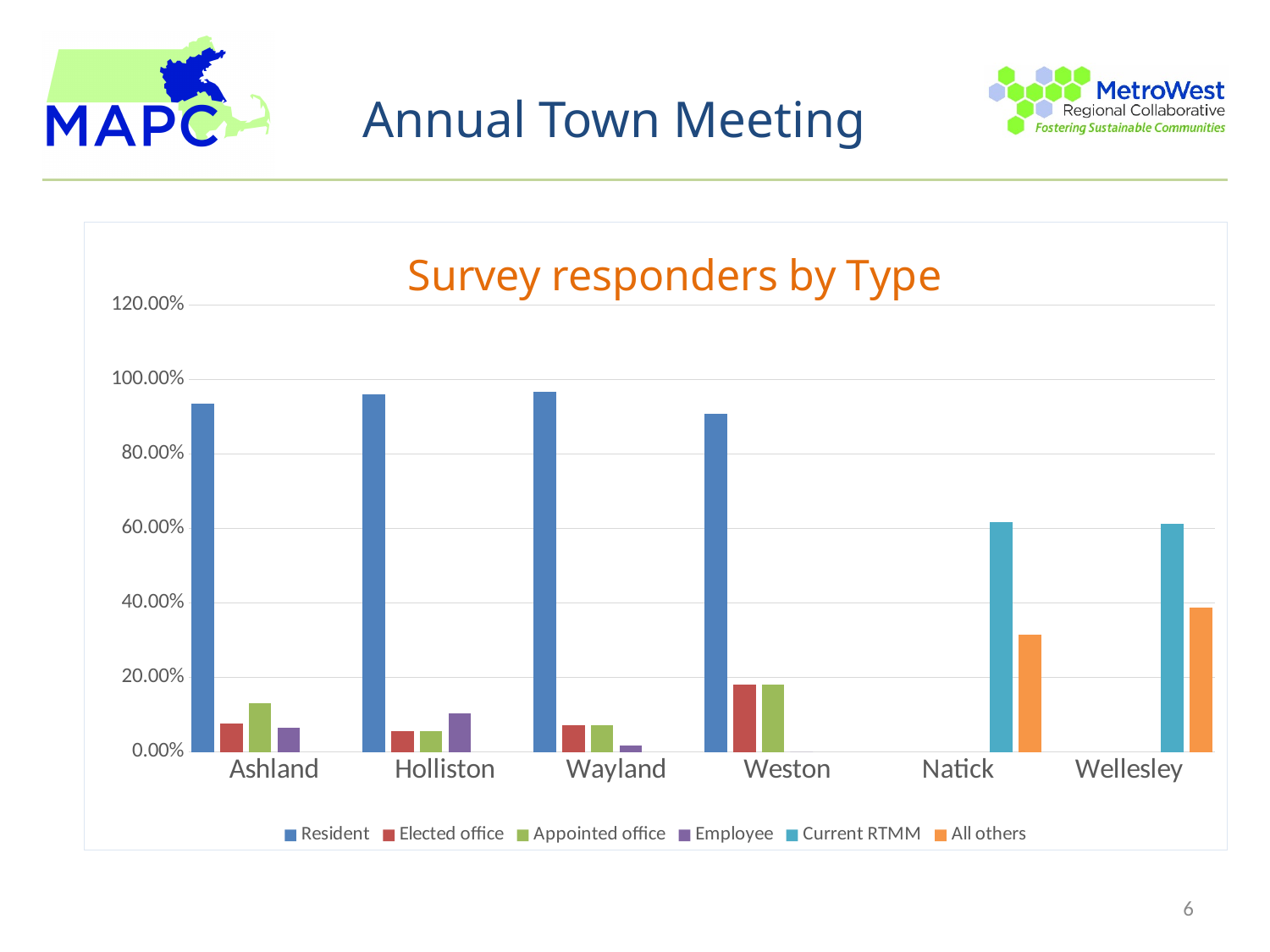
Is the Employee value for Holliston greater or less than 20.00%? less Is the All others value for Wellesley greater or less than 20.00%? greater Is the Resident value for Ashland greater or less than 80.00%? greater How many towns are shown along the x axis of the chart? 6 What is the title of the chart? Survey responders by Type Which is larger, the All others value for Wellesley or the All others value for Natick? Wellesley Which is larger, the Elected office value for Weston or the Elected office value for Ashland? Weston Which series has the highest value for Weston? Resident What kind of chart is shown on the slide? bar chart How many series does the chart's legend list? 6 Which series has the lowest value for Wayland? Employee